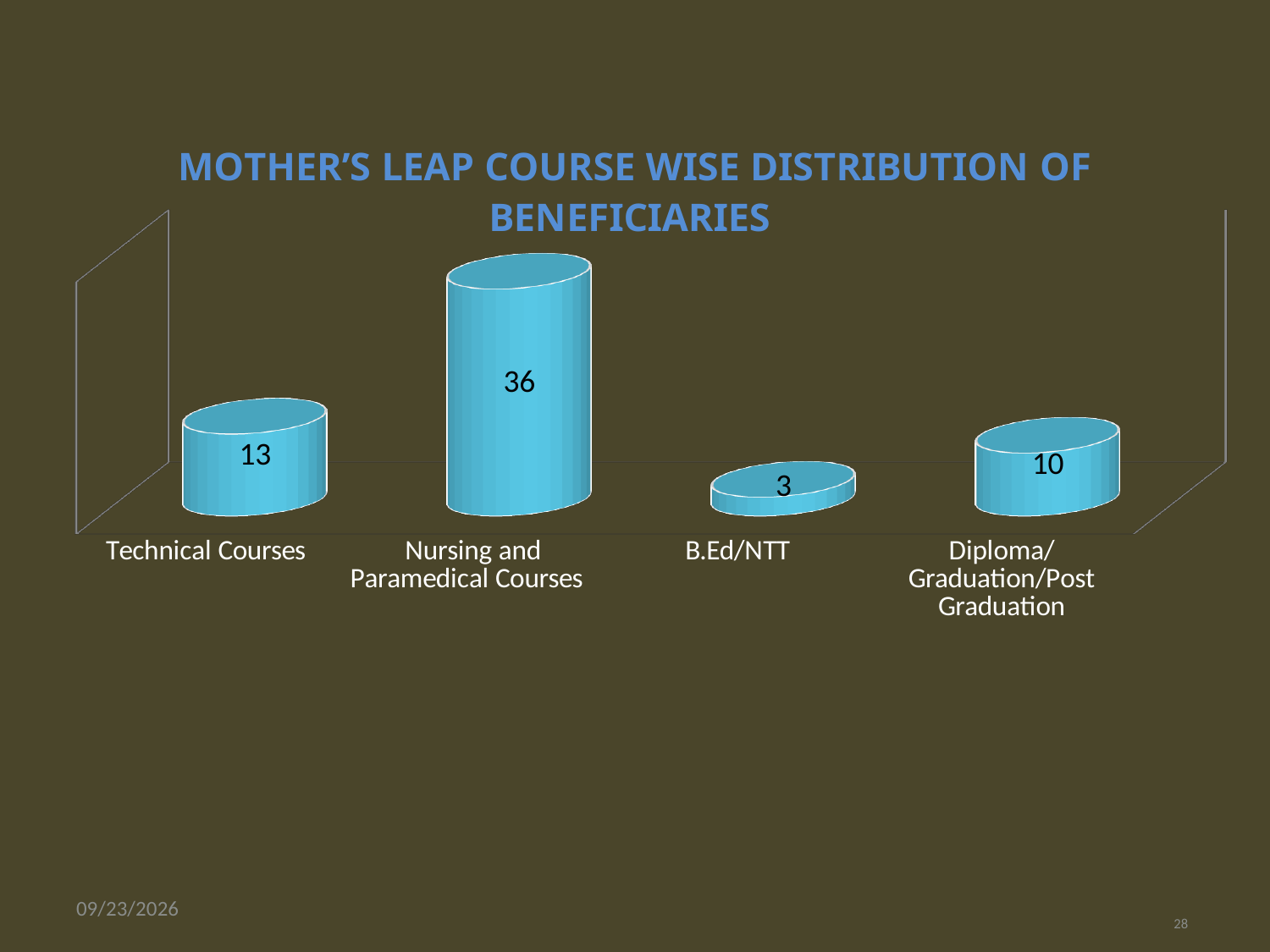
What is the title of the chart? MOTHER'S LEAP COURSE WISE DISTRIBUTION OF BENEFICIARIES What is the value for Nursing and Paramedical Courses? 36 What is the value for Diploma/Graduation/Post Graduation? 10 What kind of chart is shown on the slide? Bar chart What is the difference between the values for Nursing and Paramedical Courses and Technical Courses? 23 Which category has the highest number of beneficiaries? Nursing and Paramedical Courses What is the value for B.Ed/NTT? 3 Which category has the lowest number of beneficiaries? B.Ed/NTT What is the value for Technical Courses? 13 What is the difference between the values for Diploma/Graduation/Post Graduation and B.Ed/NTT? 7 Which is larger, the value for Technical Courses or the value for Diploma/Graduation/Post Graduation? Technical Courses How many categories are shown in the chart? 4